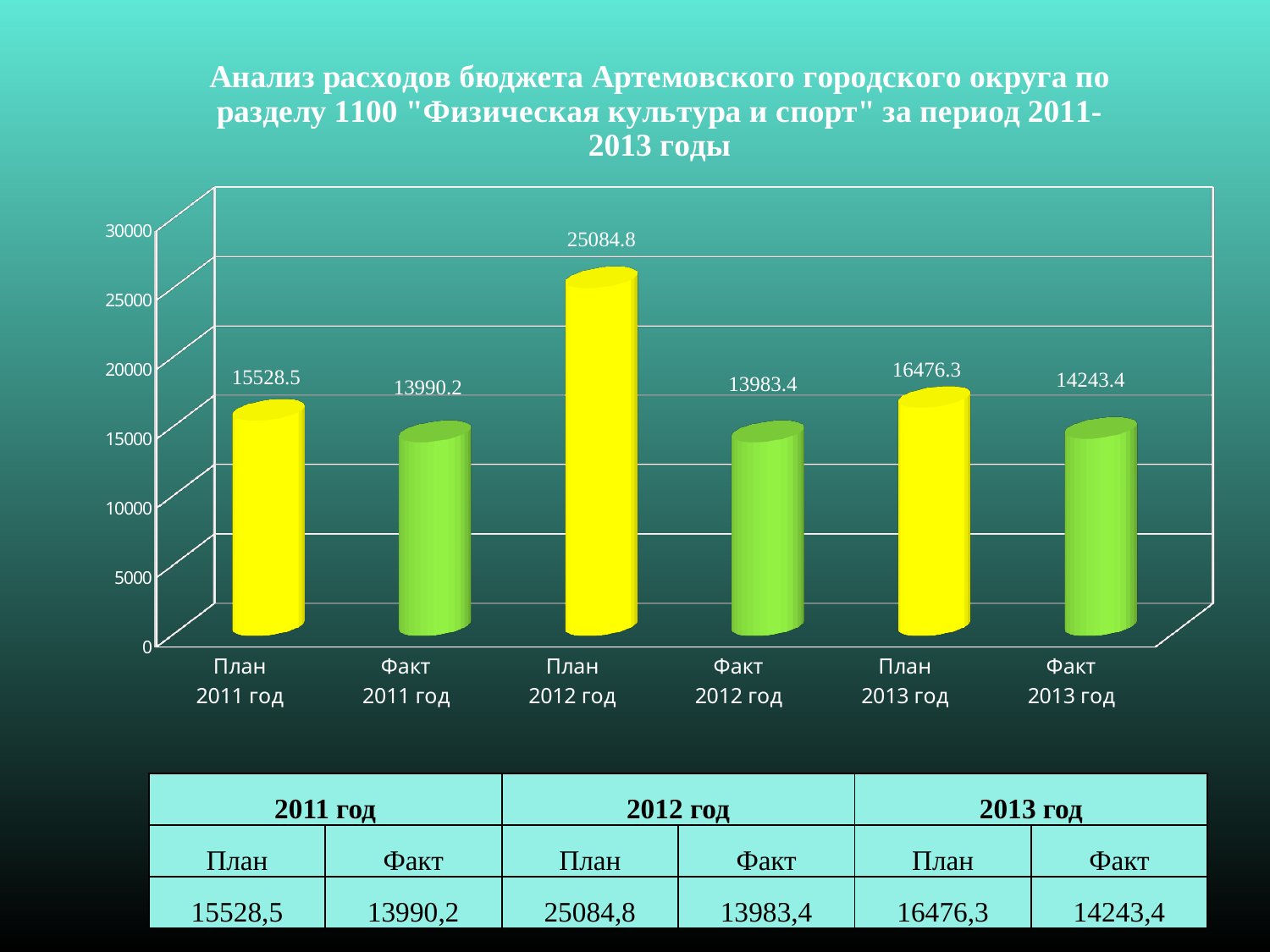
What is the value for Факт 2013 год? 14243.4 Which is larger, План 2011 год or Факт 2011 год? План 2011 год What is the value for Факт 2011 год? 13990.2 What is the value for План 2012 год? 25084.8 How many bars are shown in the chart? 6 What is the value for План 2011 год? 15528.5 What kind of chart is shown on the slide? bar chart What is the difference between План 2012 год and Факт 2012 год? 11101.4 Which category has the highest value? План 2012 год What colour are the План bars? yellow Is the value for План 2013 год greater or less than 15000? greater What is the difference between План 2013 год and Факт 2013 год? 2232.9